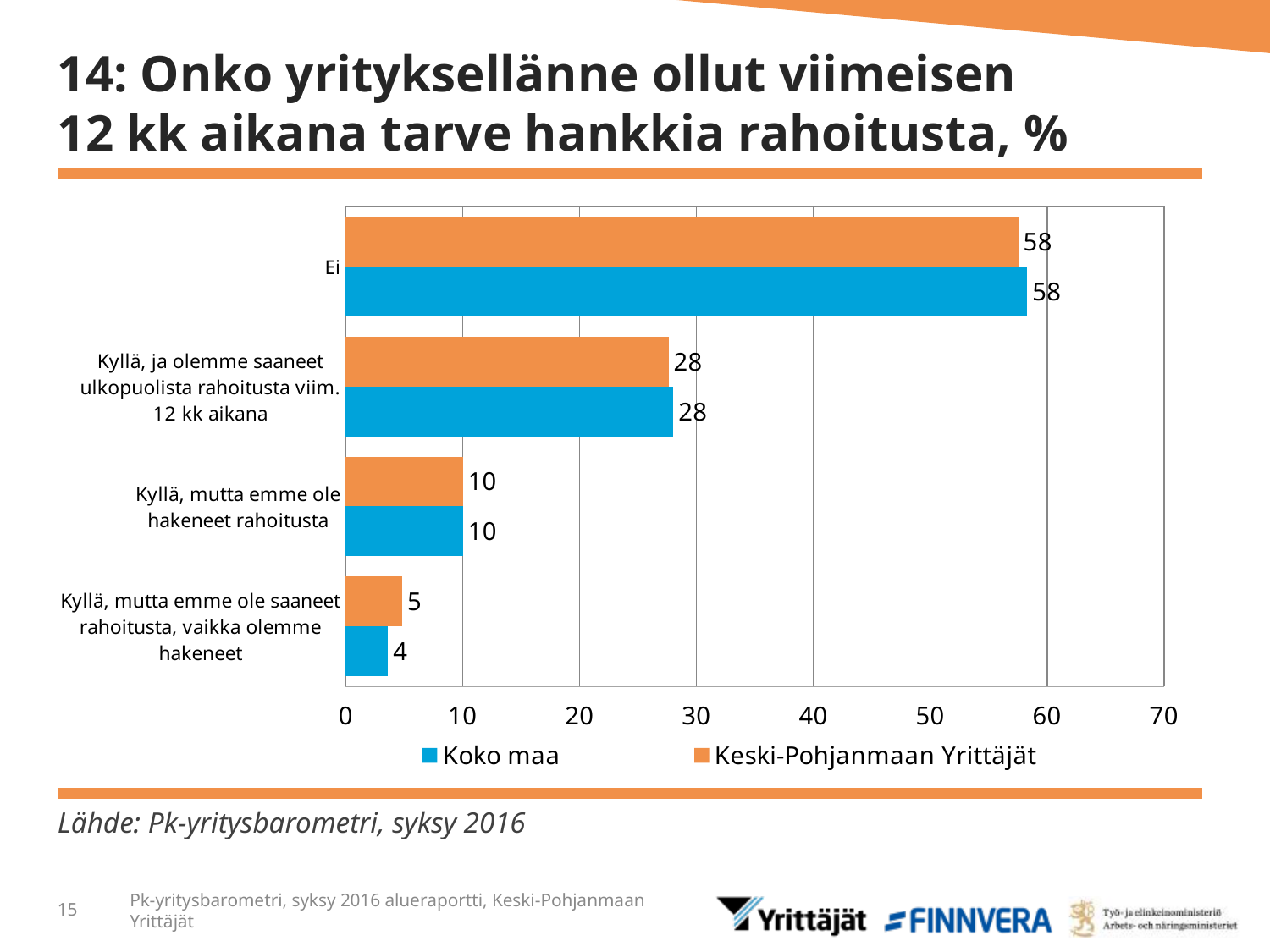
For "Kyllä, mutta emme ole saaneet rahoitusta, vaikka olemme hakeneet", which series has the larger value, Koko maa or Keski-Pohjanmaan Yrittäjät? Keski-Pohjanmaan Yrittäjät Which category has the lowest value in the Keski-Pohjanmaan Yrittäjät series? Kyllä, mutta emme ole saaneet rahoitusta, vaikka olemme hakeneet What is the difference between the Koko maa values for "Ei" and "Kyllä, ja olemme saaneet ulkopuolista rahoitusta viim. 12 kk aikana"? 30 What is the value for "Kyllä, mutta emme ole saaneet rahoitusta, vaikka olemme hakeneet" in the Keski-Pohjanmaan Yrittäjät series? 5 Which category has the highest value in the Koko maa series? Ei How many categories are shown on the chart? 4 What is the value for "Kyllä, mutta emme ole hakeneet rahoitusta" in the Koko maa series? 10 Is the Koko maa value for "Ei" greater or less than 50? greater How many series does the legend list? 2 What kind of chart is shown on the slide? Bar chart What is the value for "Ei" in the Koko maa series? 58 What is the value for "Kyllä, ja olemme saaneet ulkopuolista rahoitusta viim. 12 kk aikana" in the Keski-Pohjanmaan Yrittäjät series? 28